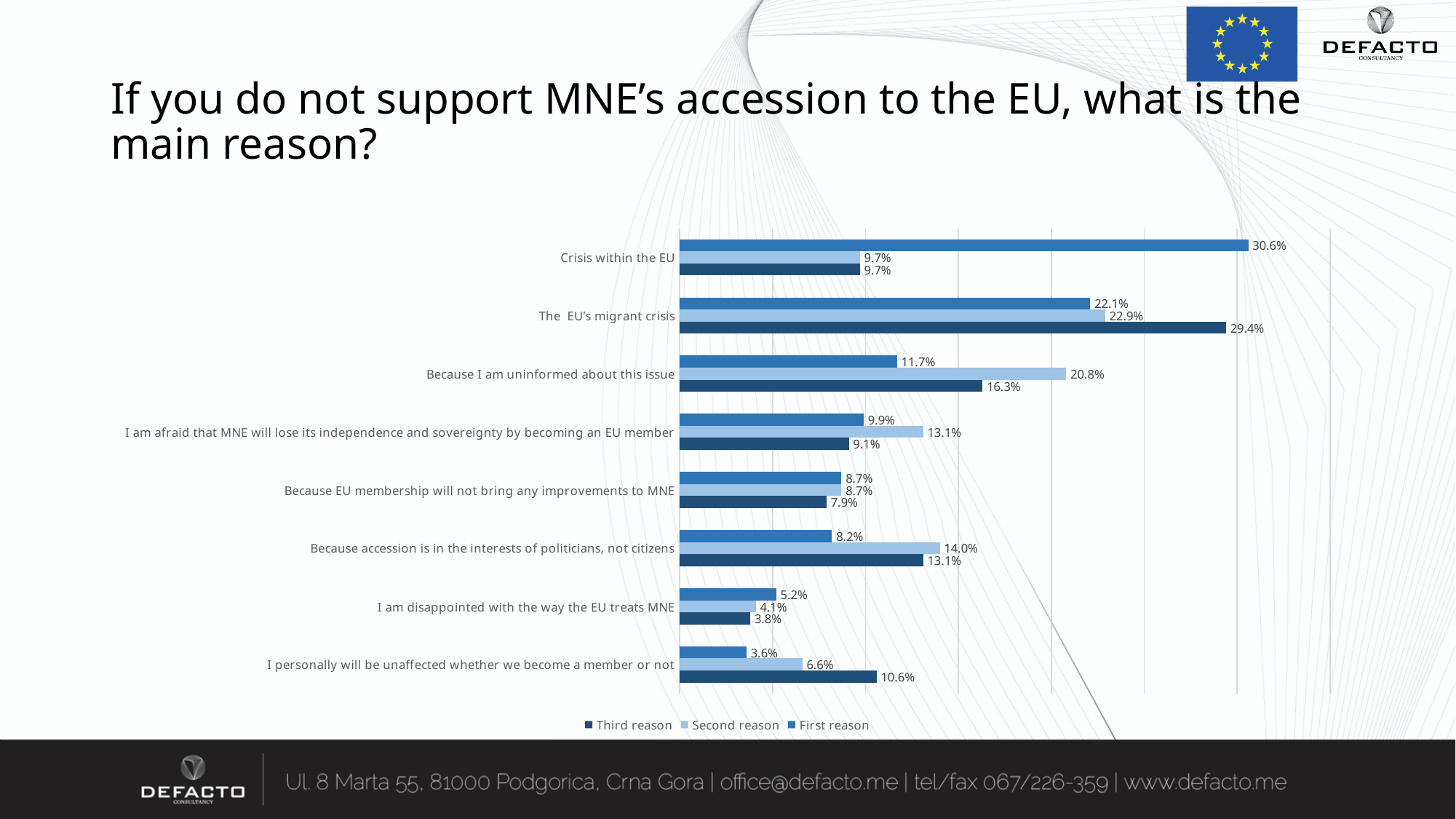
Which series is listed first in the legend? Third reason Which category has the highest First reason value? Crisis within the EU What is the First reason value for "Crisis within the EU"? 30.6% What is the Second reason value for "Because I am uninformed about this issue"? 20.8% What is the Third reason value for "The EU's migrant crisis"? 29.4% Which category has the lowest First reason value? I personally will be unaffected whether we become a member or not How many series does the legend list? 3 For "I personally will be unaffected whether we become a member or not", which is larger: the First reason value or the Third reason value? Third reason How many reason categories are plotted on the chart? 8 What kind of chart is shown on the slide? bar chart What is the Second reason value for "Because accession is in the interests of politicians, not citizens"? 14.0% What is the difference between the First reason value for "Crisis within the EU" and the First reason value for "The EU's migrant crisis"? 8.5%